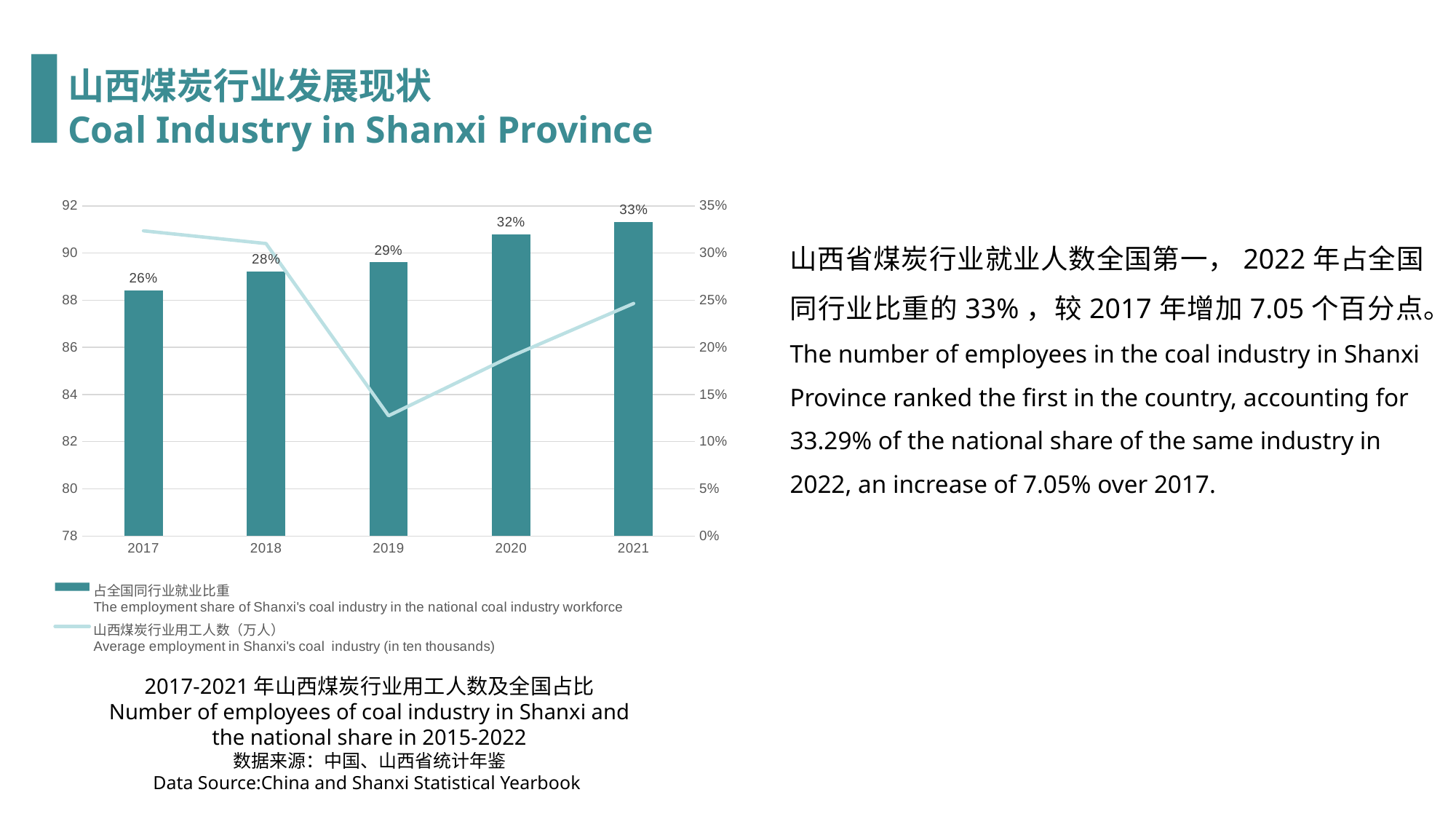
Does the employment share of Shanxi's coal industry rise or fall from 2017 to 2021? rise What is the employment share of Shanxi's coal industry in the national coal industry workforce in 2019? 29% What is the employment share of Shanxi's coal industry in the national coal industry workforce in 2021? 33% Which year has the lowest employment share of Shanxi's coal industry in the national workforce? 2017 What is the employment share of Shanxi's coal industry in the national coal industry workforce in 2017? 26% Is the average employment in Shanxi's coal industry (in ten thousands) in 2019 greater or less than 84? less Is the average employment in Shanxi's coal industry (in ten thousands) in 2017 greater or less than 90? greater Which year has the highest employment share of Shanxi's coal industry in the national workforce? 2021 What is the difference in employment share between 2021 and 2017? 7% Is the employment share higher in 2020 or in 2018? 2020 How many years are shown on the x axis of the chart? 5 How many series does the chart's legend list? 2